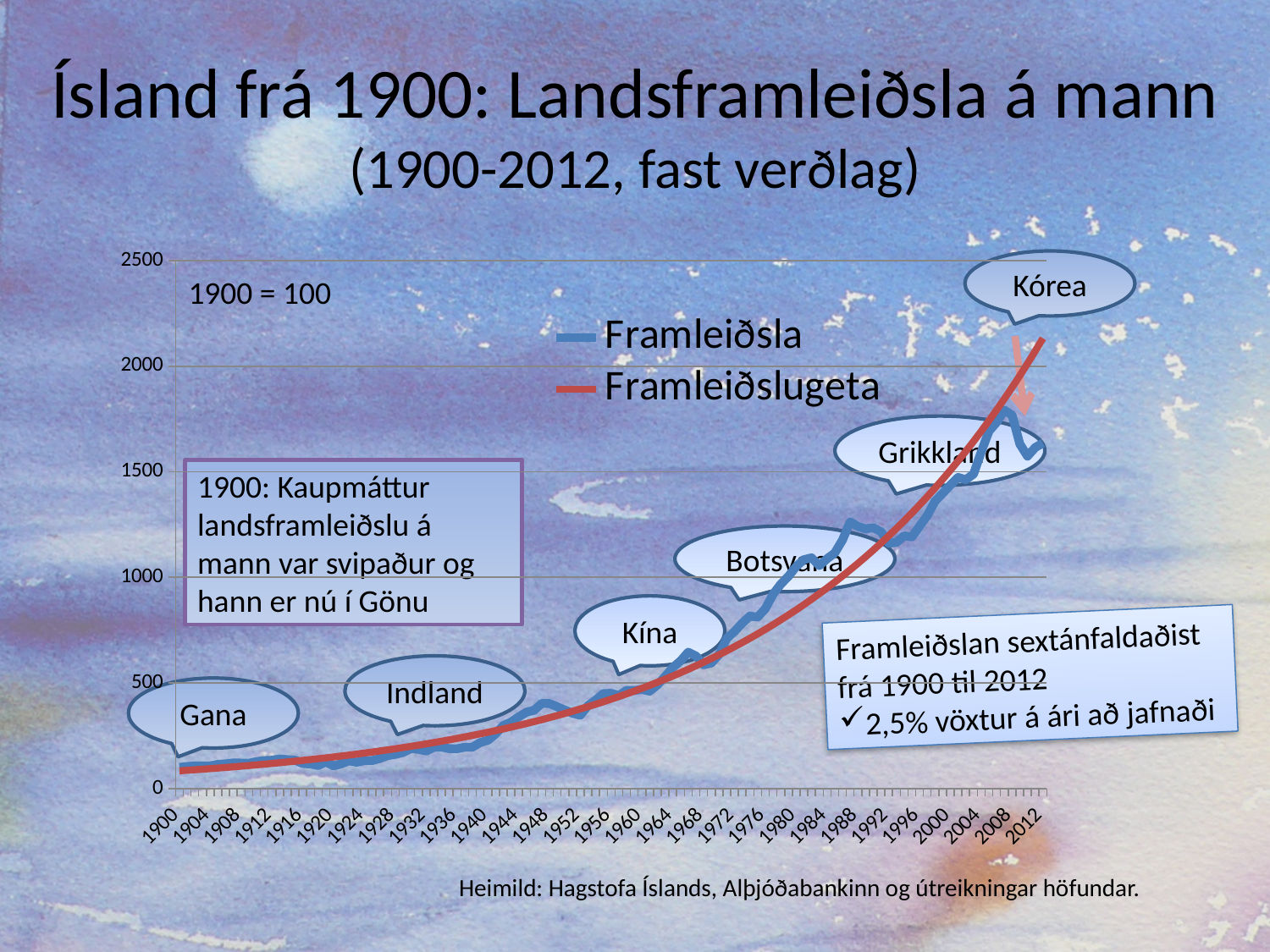
Is the value of Framleiðsla in 1960 greater or less than 1000? less In 2012, which series has the higher value, Framleiðsla or Framleiðslugeta? Framleiðslugeta Does the Framleiðsla series generally rise or fall from 1900 to 2012? rise Which series is drawn in red? Framleiðslugeta Is the value of Framleiðslugeta in 2012 greater or less than 1500? greater How many series does the chart legend list? 2 Is the value of Framleiðsla in 2008 greater or less than 1500? greater What is the highest value shown on the vertical axis of the chart? 2500 What are the two series named in the chart legend? Framleiðsla and Framleiðslugeta What kind of chart is shown on the slide? line chart